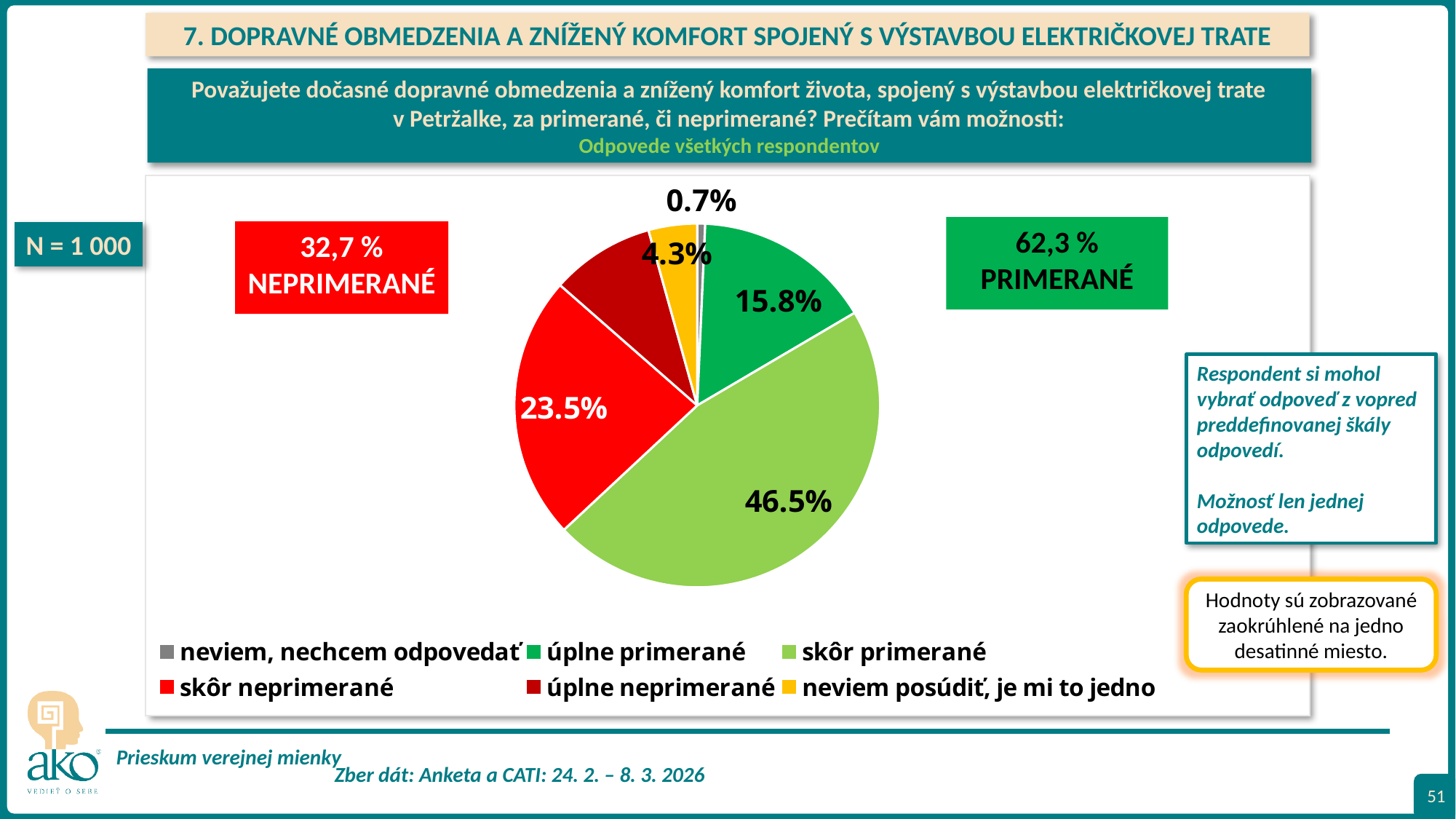
What colour is the "skôr neprimerané" slice? red What share of respondents answered "úplne primerané"? 15.8% Which answer has the smallest slice of the pie? neviem, nechcem odpovedať How many answer categories does the pie chart have? 6 Which answer has the largest slice of the pie? skôr primerané What share of respondents answered "neviem posúdiť, je mi to jedno"? 4.3% What share of respondents answered "skôr neprimerané"? 23.5% How many percentage points larger is the "skôr primerané" share than the "skôr neprimerané" share? 23 percentage points What share of respondents answered "neviem, nechcem odpovedať"? 0.7% What share of respondents answered "skôr primerané"? 46.5% What kind of chart is shown on the slide? pie chart Which slice is larger: "skôr neprimerané" or "úplne primerané"? skôr neprimerané